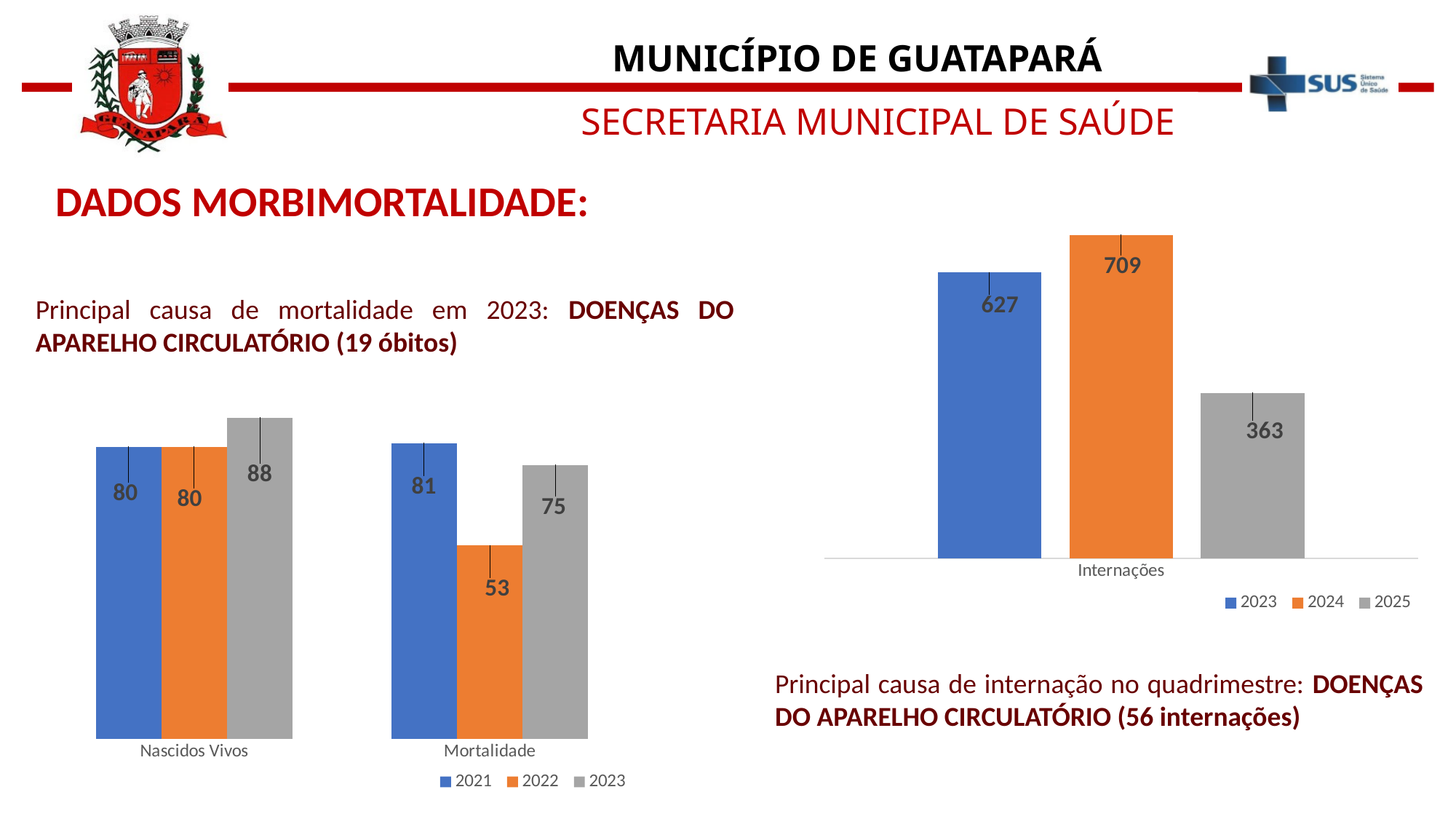
In the left chart (Nascidos Vivos / Mortalidade), which year has the lowest Mortalidade value? 2022 In the right chart (Internações), what is the difference between the 2024 and 2025 values? 346 In the right chart (Internações), what is the value for 2024? 709 In the left chart (Nascidos Vivos / Mortalidade), what is the difference between Mortalidade in 2021 and 2022? 28 In the left chart (Nascidos Vivos / Mortalidade), what is the value for Nascidos Vivos in 2023? 88 In the left chart (Nascidos Vivos / Mortalidade), what is the value for Mortalidade in 2022? 53 In the left chart (Nascidos Vivos / Mortalidade), which is larger: Nascidos Vivos in 2023 or Mortalidade in 2023? Nascidos Vivos in 2023 In the right chart (Internações), which year has the lowest value? 2025 In the left chart (Nascidos Vivos / Mortalidade), how many series does the legend list? 3 In the right chart (Internações), which year has the highest value? 2024 What kind of chart is the right chart (Internações)? Bar chart In the right chart (Internações), what colour is the bar for 2025? Grey